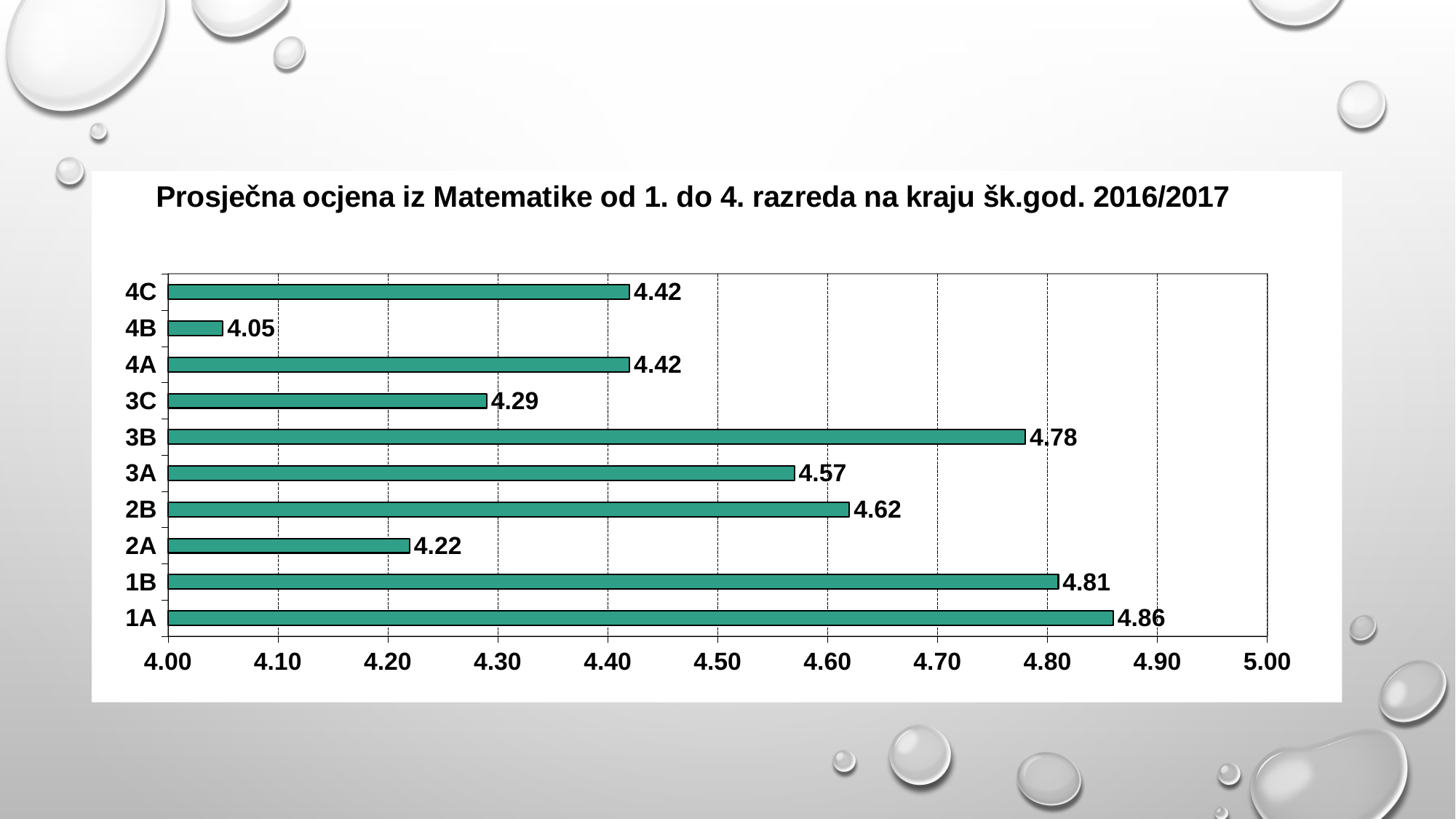
How many classes are shown in the chart? 10 Which class has the lowest average Mathematics grade? 4B Which class has the highest average Mathematics grade? 1A What kind of chart is shown on the slide? Bar chart What is the title of the chart? Prosječna ocjena iz Matematike od 1. do 4. razreda na kraju šk.god. 2016/2017 What is the average Mathematics grade for class 1A? 4.86 Which class has a higher average grade, 3A or 3C? 3A Is the value for class 2B greater or less than 4.50? greater What is the difference between the average grades of class 2B and class 2A? 0.40 What is the average Mathematics grade for class 4B? 4.05 What is the average Mathematics grade for class 3B? 4.78 What is the difference between the average grades of class 1A and class 4B? 0.81